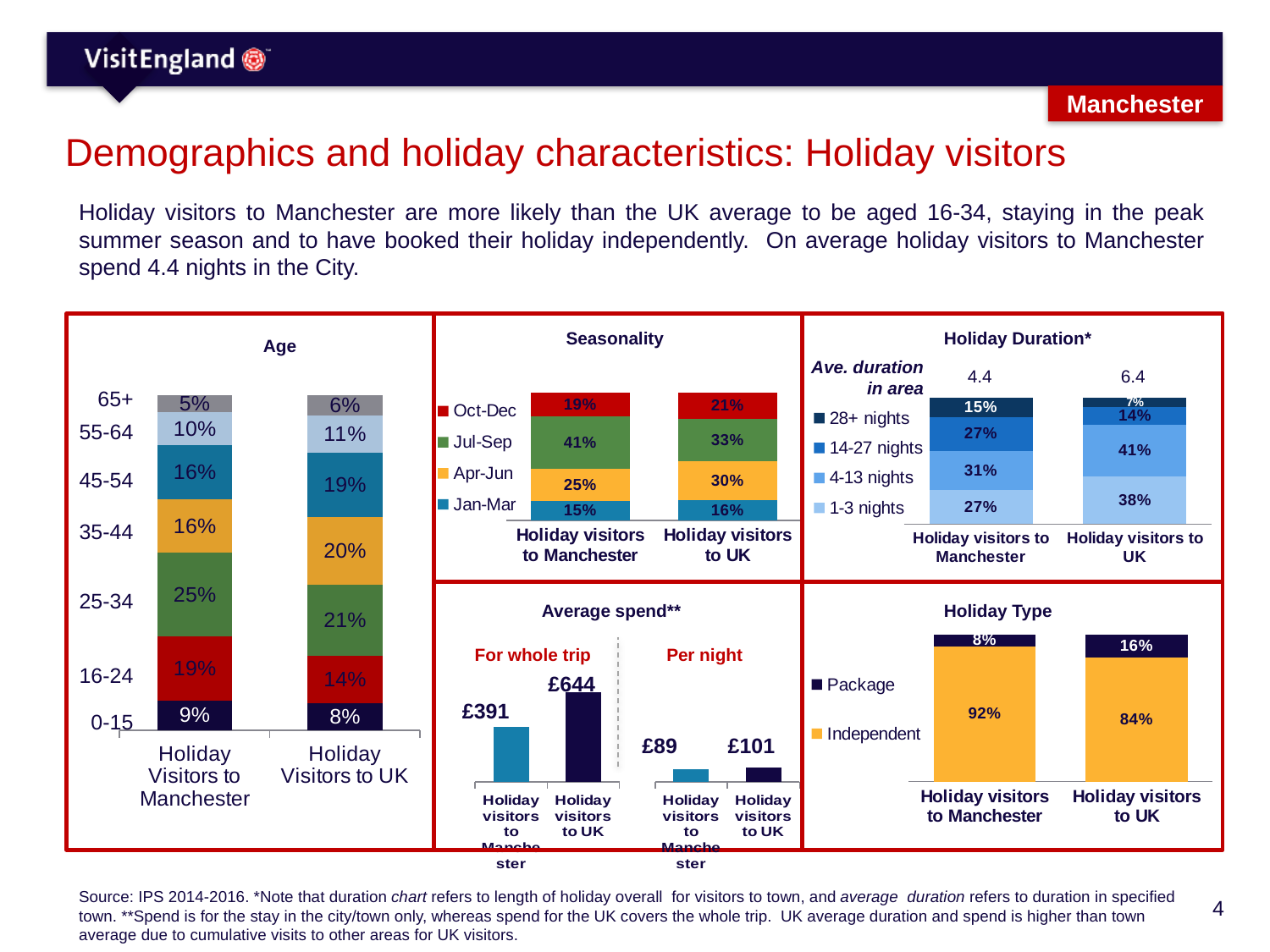
In the Holiday Duration chart, what is the average duration in area for holiday visitors to Manchester? 4.4 In the Age chart, what is the difference between the 16-24 share for holiday visitors to Manchester and for holiday visitors to the UK? 5% In the Average spend chart, what is the difference in per night spend between holiday visitors to the UK and holiday visitors to Manchester? £12 In the Average spend chart, what is the spend for the whole trip for holiday visitors to the UK? £644 In the Holiday Duration chart, what share of holiday visitors to the UK stay 4-13 nights? 41% In the Seasonality chart, which is larger: the Apr-Jun share for holiday visitors to Manchester or for holiday visitors to the UK? Holiday visitors to UK What kind of chart is the Holiday Type chart? Stacked bar chart In the Age chart, what share of holiday visitors to Manchester are aged 25-34? 25% In the Age chart, which age group has the largest share among holiday visitors to Manchester? 25-34 In the Seasonality chart, how many series does the legend list? 4 In the Holiday Type chart, what share of holiday visitors to Manchester booked a package holiday? 8% In the Seasonality chart, what share of holiday visitors to Manchester visit in Jul-Sep? 41%